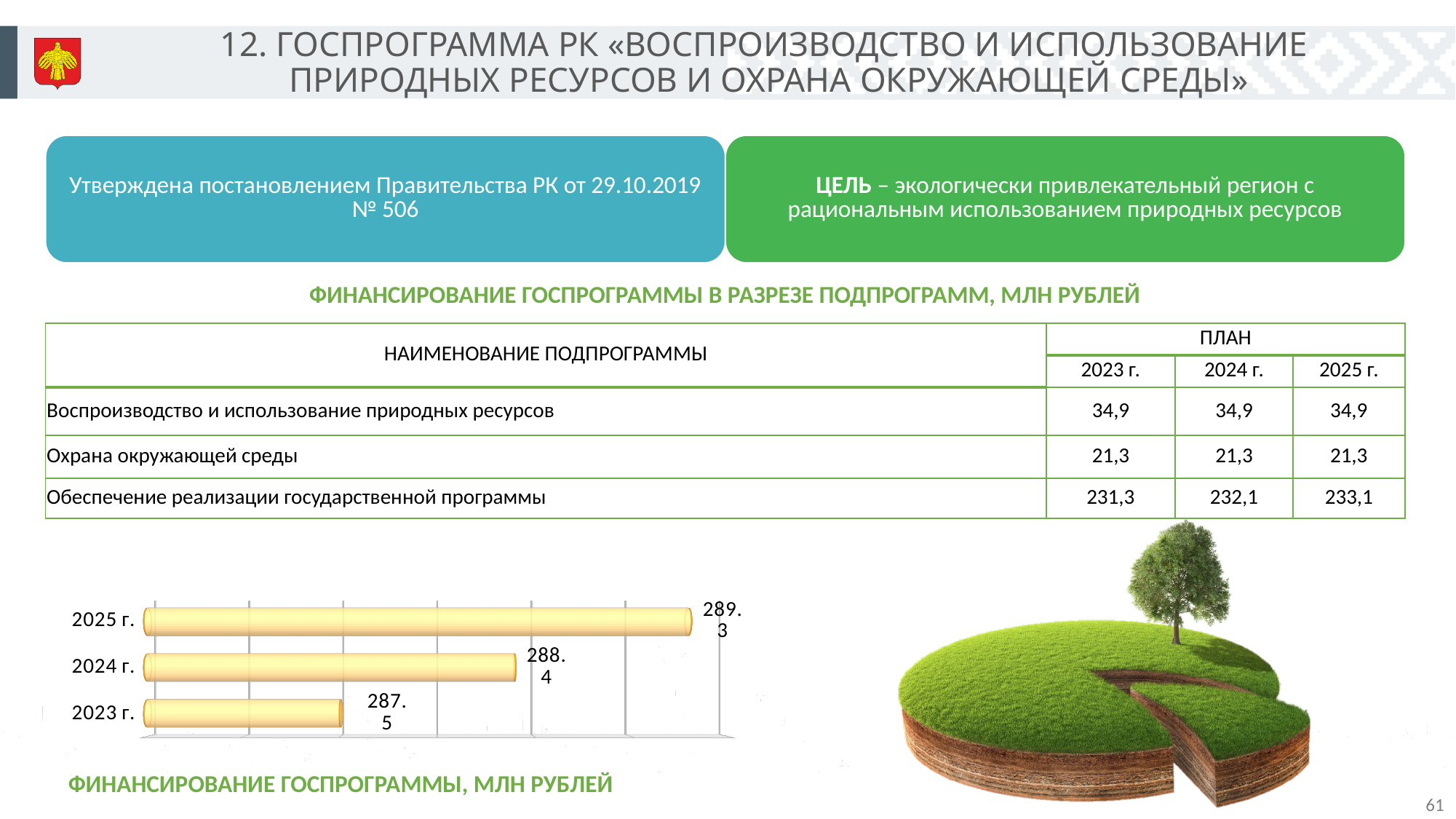
Which is larger in the bar chart, the value for 2024 г. or the value for 2025 г.? 2025 г. Do the values in the bar chart rise or fall from 2023 г. to 2025 г.? rise What is the value for 2024 г. in the bar chart? 288.4 Which year has the highest value in the bar chart? 2025 г. How many years (categories) are shown in the bar chart? 3 What is the value for 2023 г. in the bar chart? 287.5 What is the difference between the values for 2024 г. and 2023 г. in the bar chart? 0.9 What is the difference between the values for 2025 г. and 2023 г. in the bar chart? 1.8 What type of chart is shown at the bottom left of the slide? bar chart What is the value for 2025 г. in the bar chart? 289.3 What is the title shown below the bar chart? ФИНАНСИРОВАНИЕ ГОСПРОГРАММЫ, МЛН РУБЛЕЙ Which year has the lowest value in the bar chart? 2023 г.